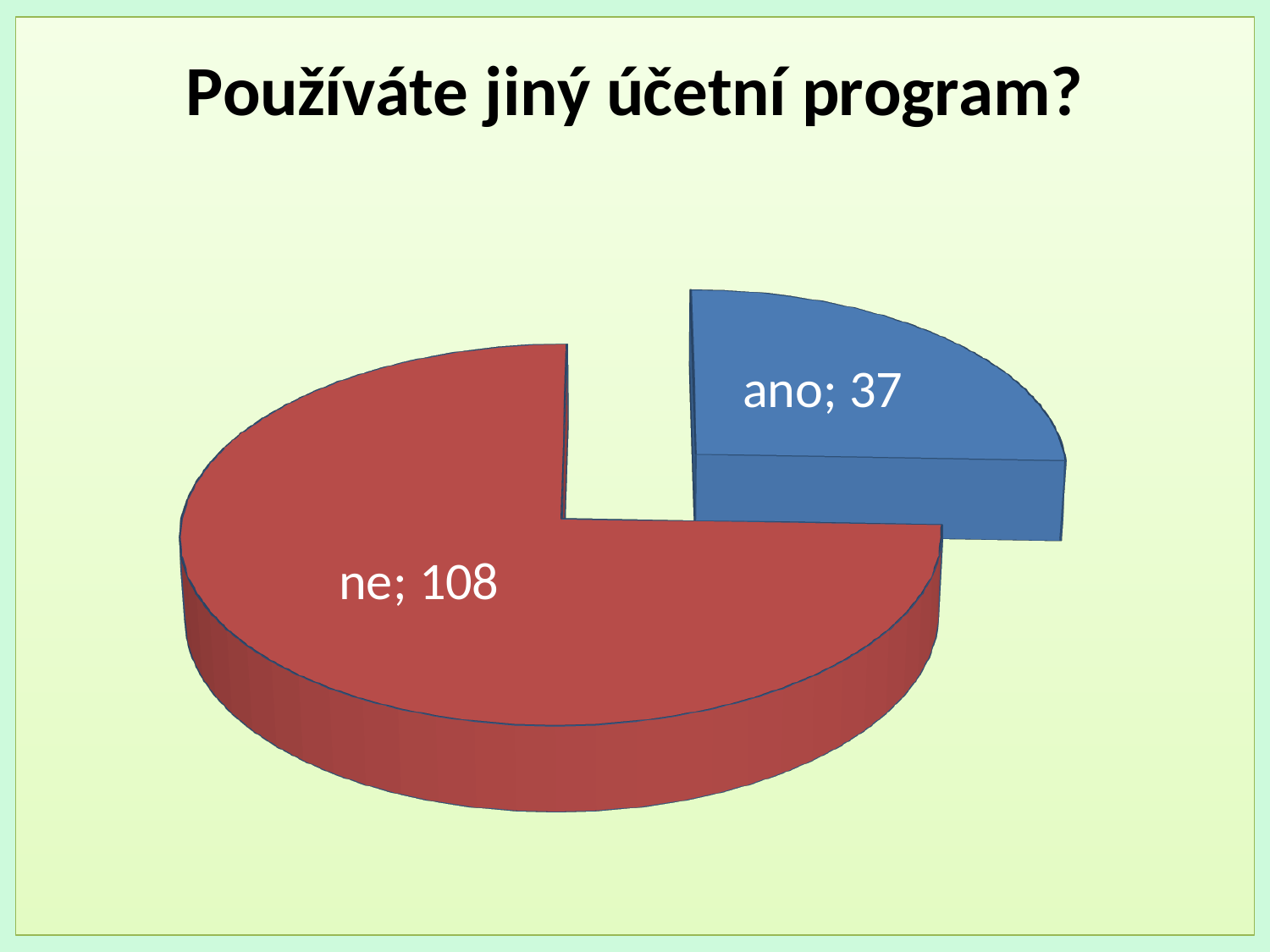
What is the total of all slices in the pie chart? 145 What share of the pie does the "ano" slice represent? 25.5% How many slices does the pie chart have? 2 Which category has the largest slice? ne Which category has the smallest slice? ano What is the difference between the values for "ne" and "ano"? 71 What is the title of the chart? Používáte jiný účetní program? What is the value for "ano"? 37 What colour is the "ano" slice? blue What kind of chart is shown on the slide? pie chart Which is larger, the value for "ano" or the value for "ne"? ne What is the value for "ne"? 108